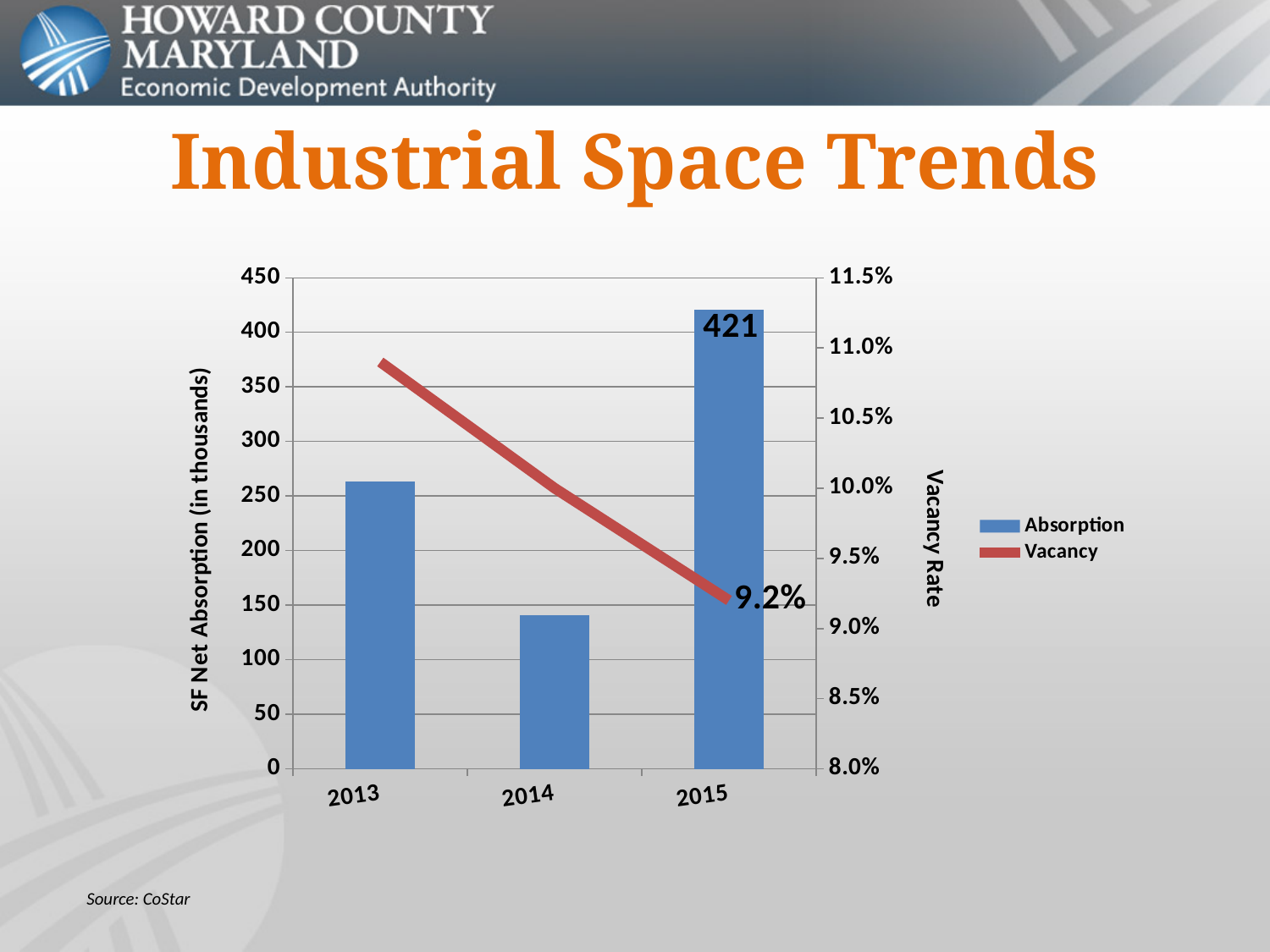
What is the absorption value for 2015? 421 Which year has the lowest absorption? 2014 How many years are shown on the x axis? 3 Is the vacancy rate for 2013 greater or less than 10.5%? greater What is the vacancy rate shown for 2015? 9.2% Which year has the larger absorption, 2013 or 2014? 2013 Which year has the highest absorption? 2015 Is the absorption value for 2014 greater or less than 150? less What is the title of the chart? Industrial Space Trends How many series does the legend list? 2 Does the vacancy rate rise or fall from 2013 to 2015? fall Is the absorption value for 2013 greater or less than 250? greater